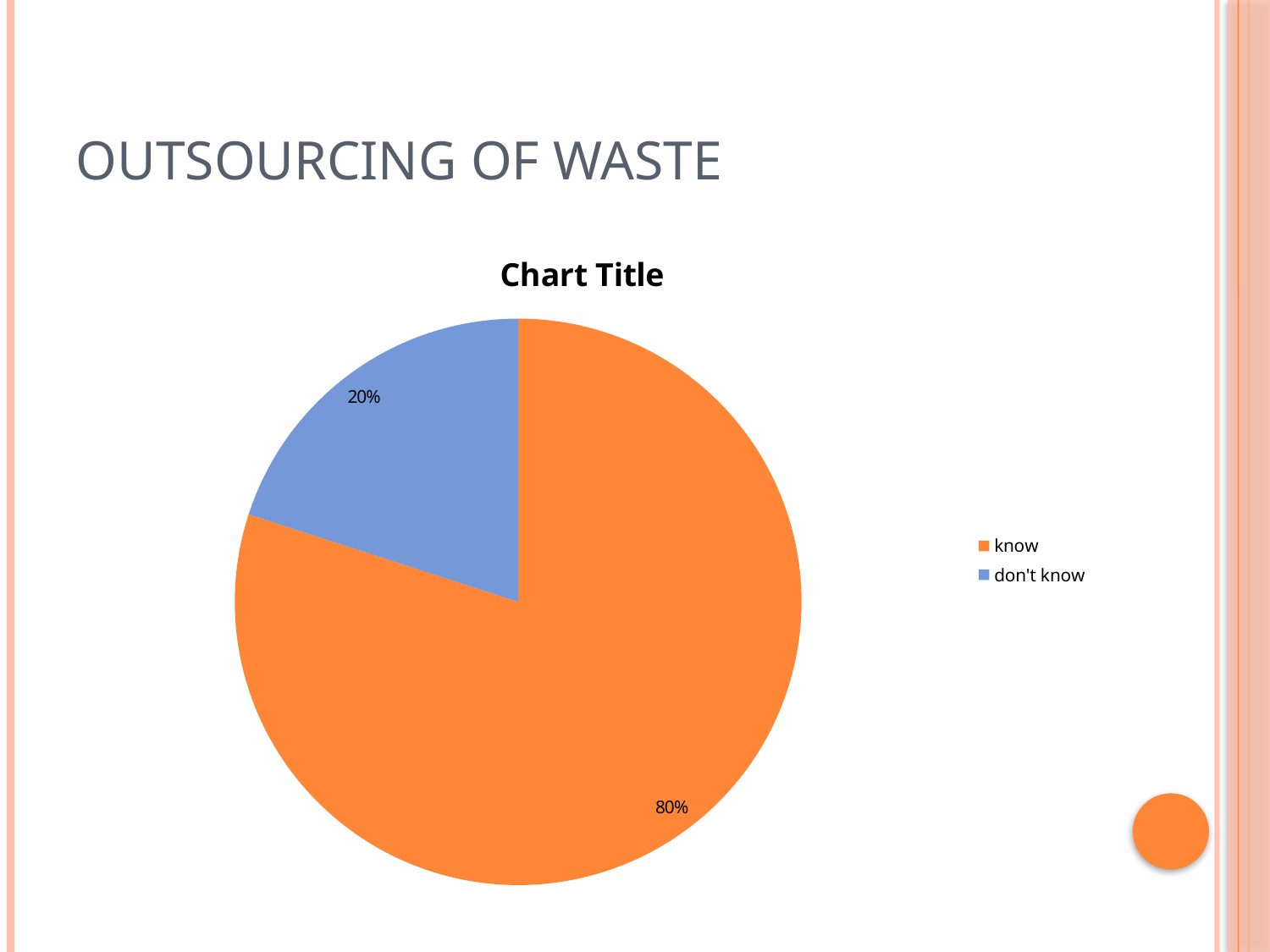
What colour is the "don't know" slice? blue Which category has the smallest slice of the pie? don't know What share of the pie does the "don't know" slice represent? 20% What kind of chart is shown on the slide? pie chart What share of the pie does the "know" slice represent? 80% What is the title shown above the pie chart? Chart Title Which is larger, the "know" slice or the "don't know" slice? know What is the difference in percentage points between the "know" and "don't know" slices? 60 percentage points Which category has the largest slice of the pie? know How many categories does the pie chart show? 2 How many entries does the legend list? 2